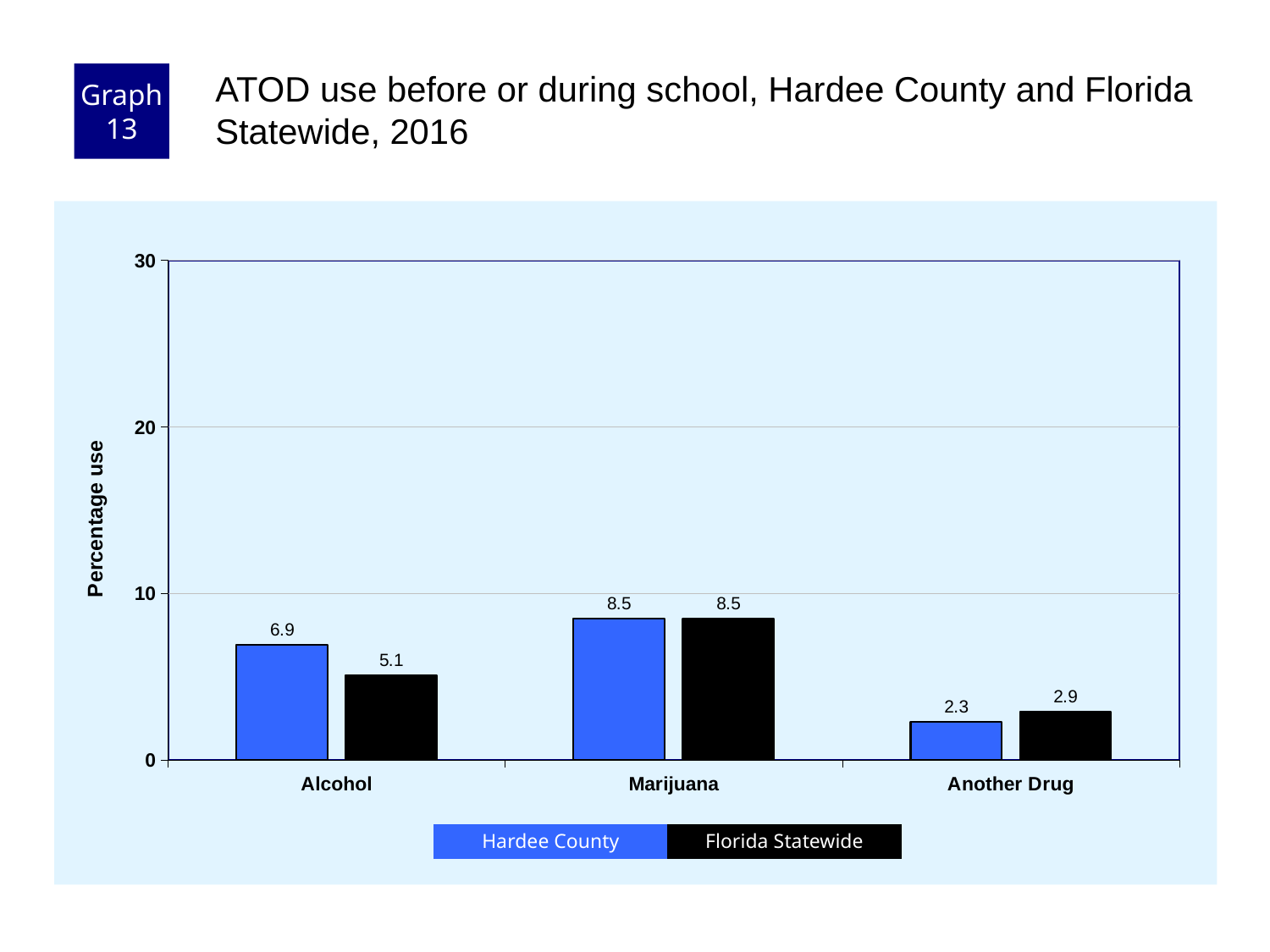
Which category has the highest Hardee County value? Marijuana What is the Hardee County value for Alcohol? 6.9 What is the Florida Statewide value for Another Drug? 2.9 How many categories are shown on the x axis? 3 Which category has the lowest Florida Statewide value? Another Drug What kind of chart is shown on the slide? bar chart What is the label of the y axis? Percentage use Is the Hardee County value for Marijuana greater or less than 10? less What is the Florida Statewide value for Alcohol? 5.1 How many series does the legend list? 2 What is the difference between the Hardee County and Florida Statewide values for Alcohol? 1.8 For Another Drug, which is larger: Hardee County or Florida Statewide? Florida Statewide